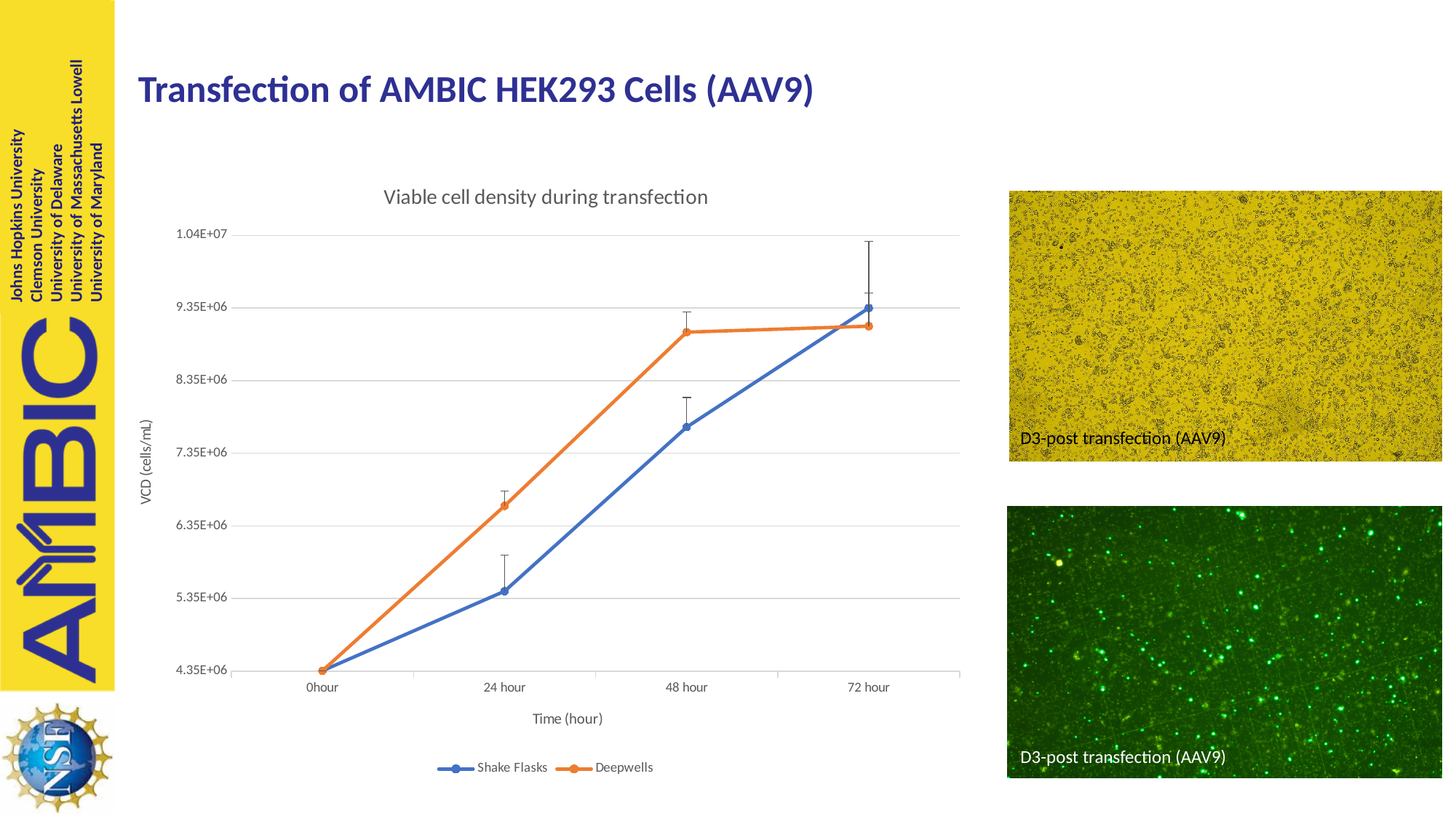
What is the title of the chart? Viable cell density during transfection How many series does the chart legend list? 2 Is the value for Deepwells at 24 hour greater or less than 6.35E+06? greater At 24 hour, which series has the higher viable cell density, Shake Flasks or Deepwells? Deepwells Does the Shake Flasks series rise or fall from 0hour to 72 hour? Rises Is the value for Deepwells at 48 hour greater or less than 8.35E+06? greater What is the label of the y axis? VCD (cells/mL) Is the value for Shake Flasks at 24 hour greater or less than 6.35E+06? less How many time points are plotted along the x axis? 4 What type of chart is shown on the slide? Line chart At 48 hour, which series has the higher viable cell density, Shake Flasks or Deepwells? Deepwells